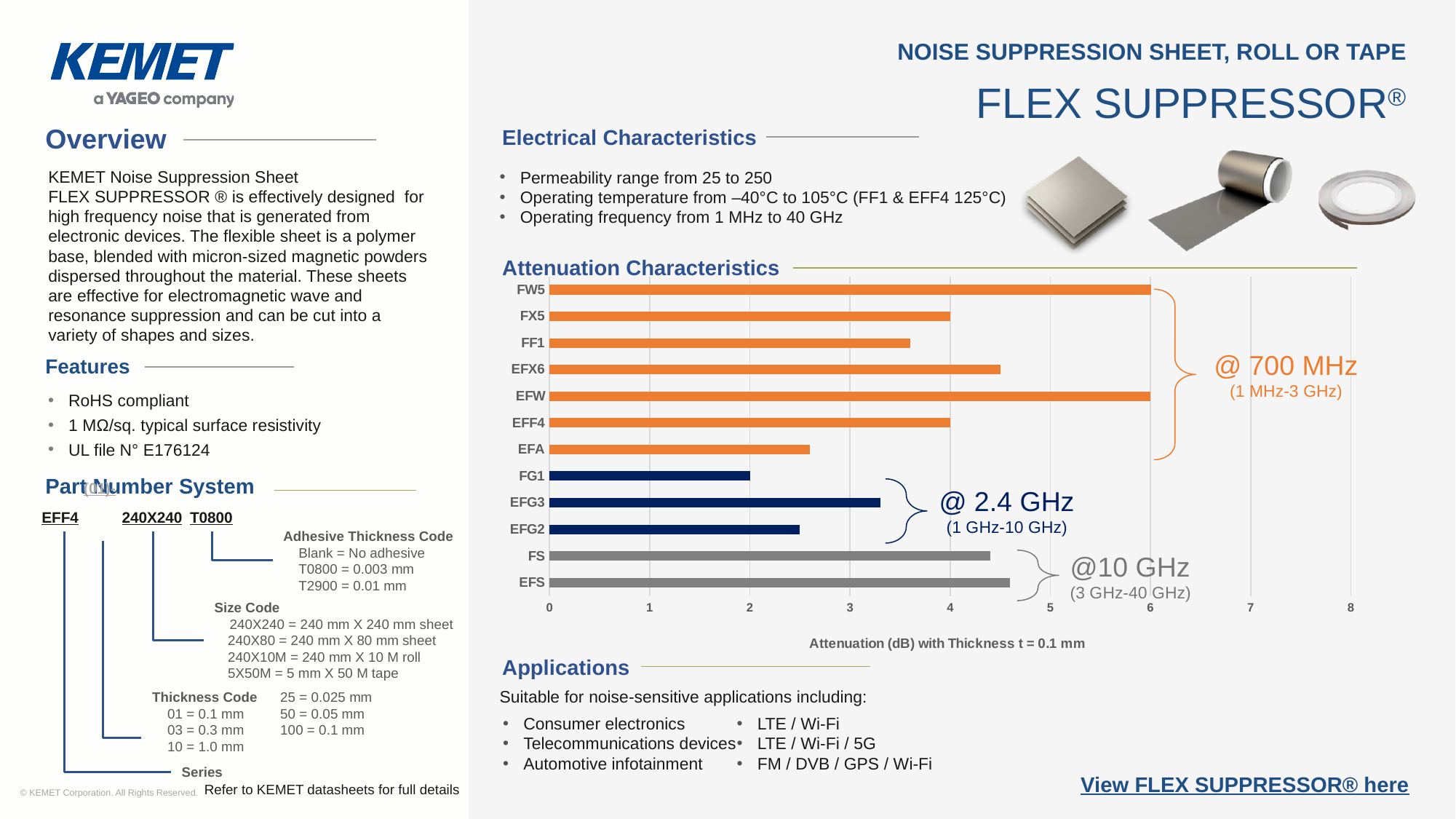
In the Attenuation Characteristics chart, is the value for EFS greater or less than 4? greater In the Attenuation Characteristics chart, which frequency group do the orange bars represent? @ 700 MHz (1 MHz-3 GHz) In the Attenuation Characteristics chart, is the value for EFG2 greater or less than 3? less In the Attenuation Characteristics chart, is the value for EFX6 greater or less than 4? greater What is the x-axis label of the Attenuation Characteristics chart? Attenuation (dB) with Thickness t = 0.1 mm What kind of chart is used for the Attenuation Characteristics? bar chart How many product series are plotted in the Attenuation Characteristics chart? 12 In the Attenuation Characteristics chart, which has the higher attenuation, EFG3 or EFG2? EFG3 Which series has the lowest attenuation in the Attenuation Characteristics chart? FG1 In the Attenuation Characteristics chart, which has the higher attenuation, FW5 or FX5? FW5